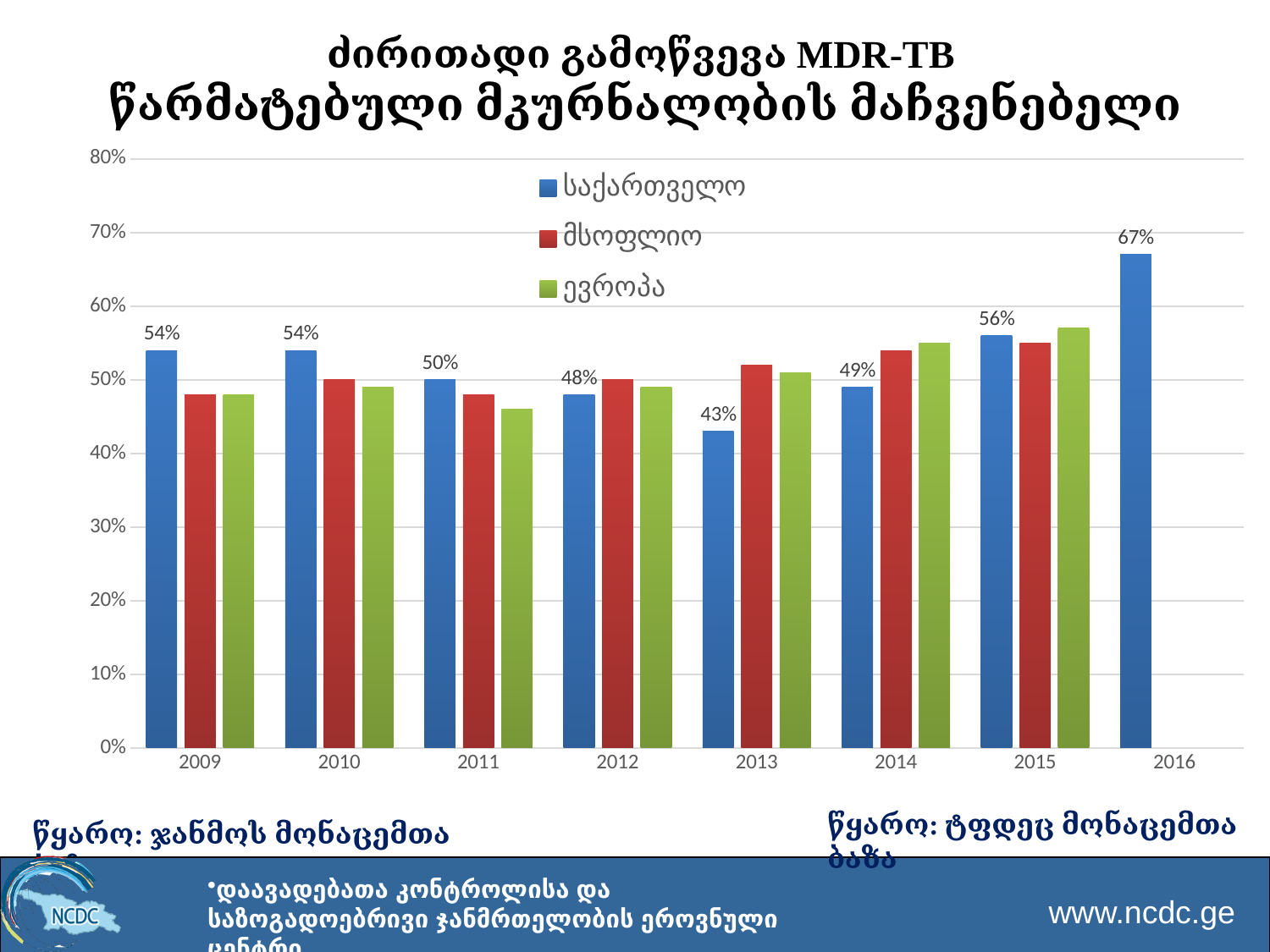
What kind of chart is shown on the slide? Bar chart Is the value for ევროპა in 2014 greater or less than 50%? greater What is the value for საქართველო in 2016? 67% What is the difference between the საქართველო values for 2016 and 2013? 24 percentage points What is the value for საქართველო in 2013? 43% Which is larger, the საქართველო value for 2015 or for 2014? 2015 In which year is the value for საქართველო highest? 2016 How many years are shown on the x axis? 8 How many series does the legend list? 3 Is the value for ევროპა in 2011 greater or less than 50%? less What is the value for საქართველო in 2011? 50% In which year is the value for საქართველო lowest? 2013